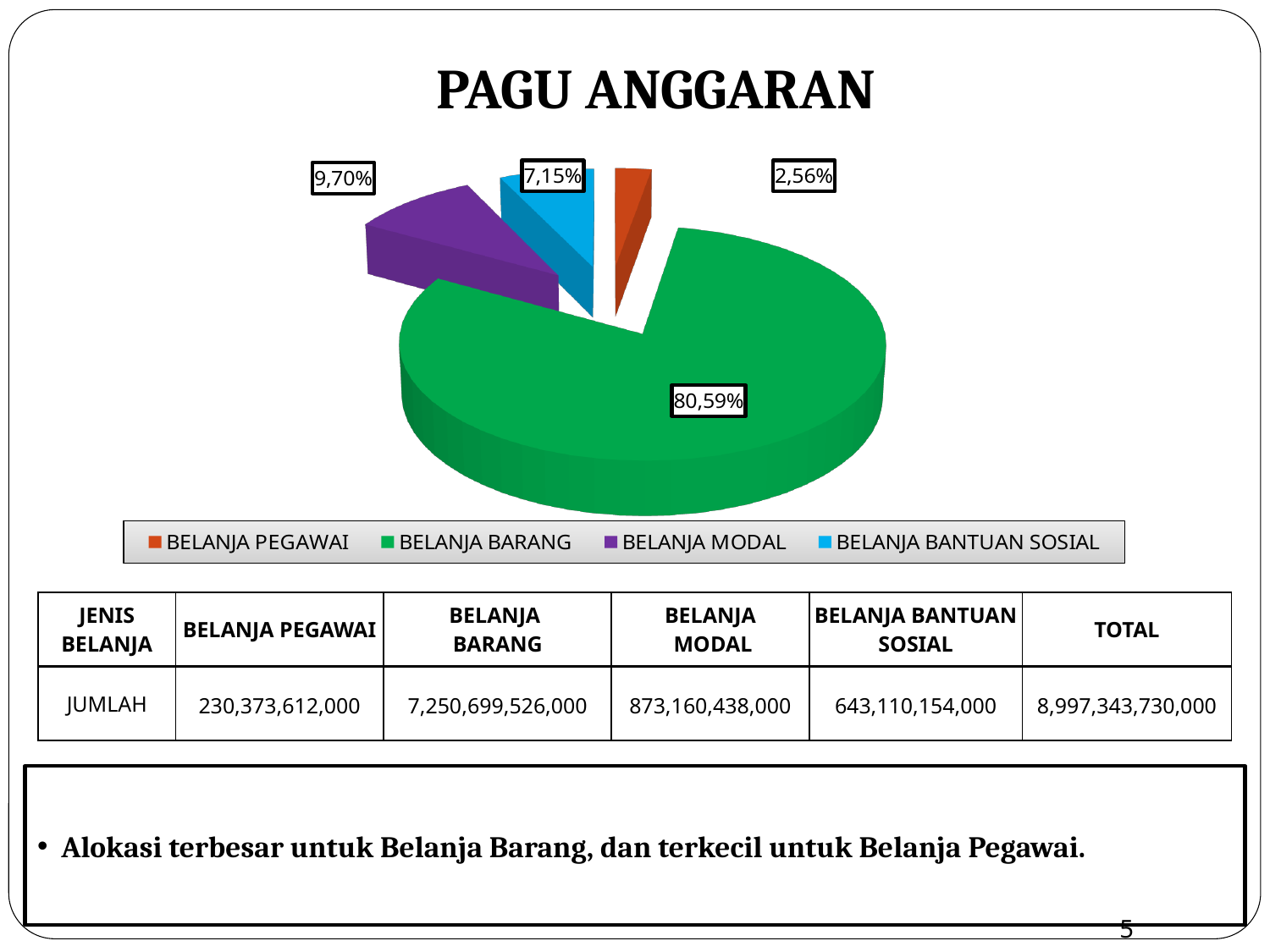
Which category has the largest slice of the pie? BELANJA BARANG What share of the pie does BELANJA PEGAWAI represent? 2,56% How many entries does the legend list? 4 What type of chart is shown on the slide? pie chart What share of the pie does BELANJA MODAL represent? 9,70% What share of the pie does BELANJA BANTUAN SOSIAL represent? 7,15% What is the title of the chart? PAGU ANGGARAN Which category has the smallest slice of the pie? BELANJA PEGAWAI Which slice is larger, BELANJA MODAL or BELANJA BANTUAN SOSIAL? BELANJA MODAL How many slices does the pie chart have? 4 What colour is the BELANJA MODAL slice in the pie chart? purple